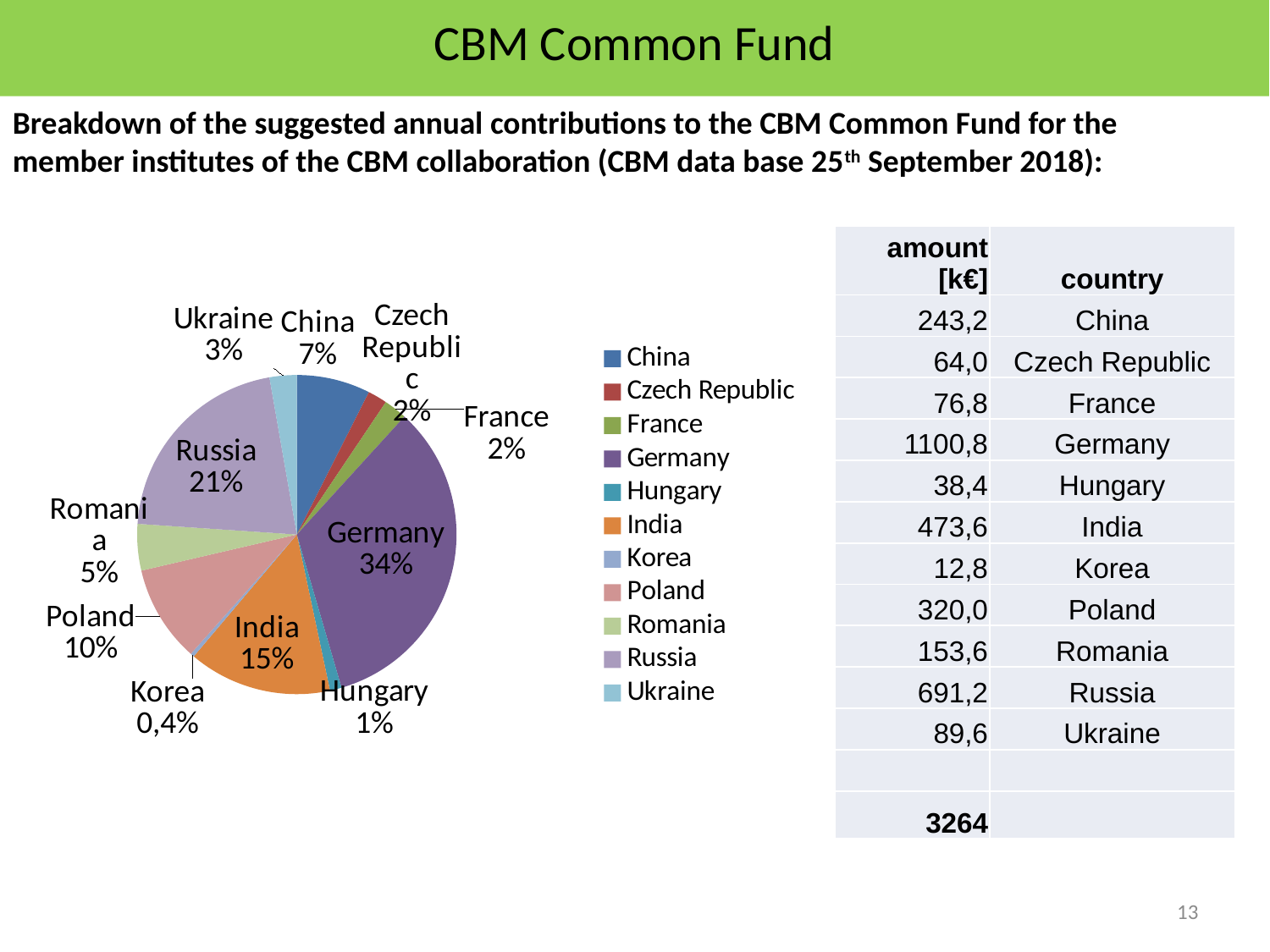
How many countries are shown as slices in the pie chart? 11 What percentage is shown for India in the pie chart? 15% What share of the pie does Germany hold? 34% What percentage is shown for Ukraine in the pie chart? 3% What type of chart is shown on the slide? pie chart Which has a larger share of the pie, Poland or Romania? Poland What percentage is shown for Korea in the pie chart? 0,4% Which country has the smallest slice of the pie chart? Korea What is the difference in percentage points between Germany's and Russia's shares? 13 Which country has the largest slice of the pie chart? Germany Which legend entry is listed first in the pie chart's legend? China What percentage is shown for Russia in the pie chart? 21%